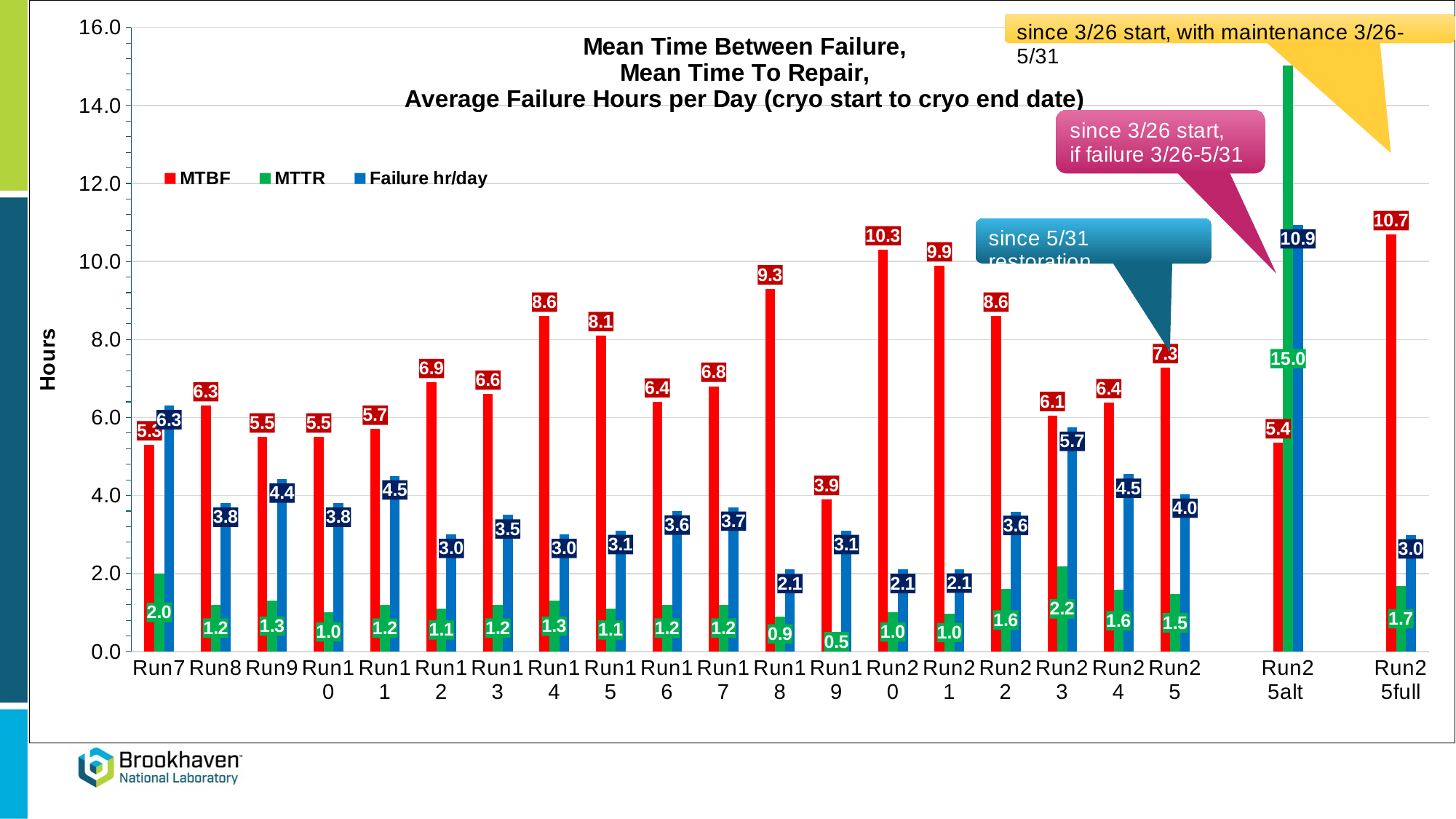
How many series does the legend list? 3 What is the difference between the MTBF of Run25full and the MTBF of Run25alt? 5.3 Which run has the lowest MTTR? Run19 Which run has the lowest MTBF? Run19 Which is larger, the Failure hr/day for Run7 or for Run8? Run7 What is the label of the y axis? Hours What kind of chart is shown on the slide? Bar chart What is the Failure hr/day value for Run23? 5.7 Which run has the highest MTBF? Run25full What is the MTTR value for Run25alt? 15.0 What is the MTBF value for Run20? 10.3 How many runs (categories) are shown on the x axis? 21